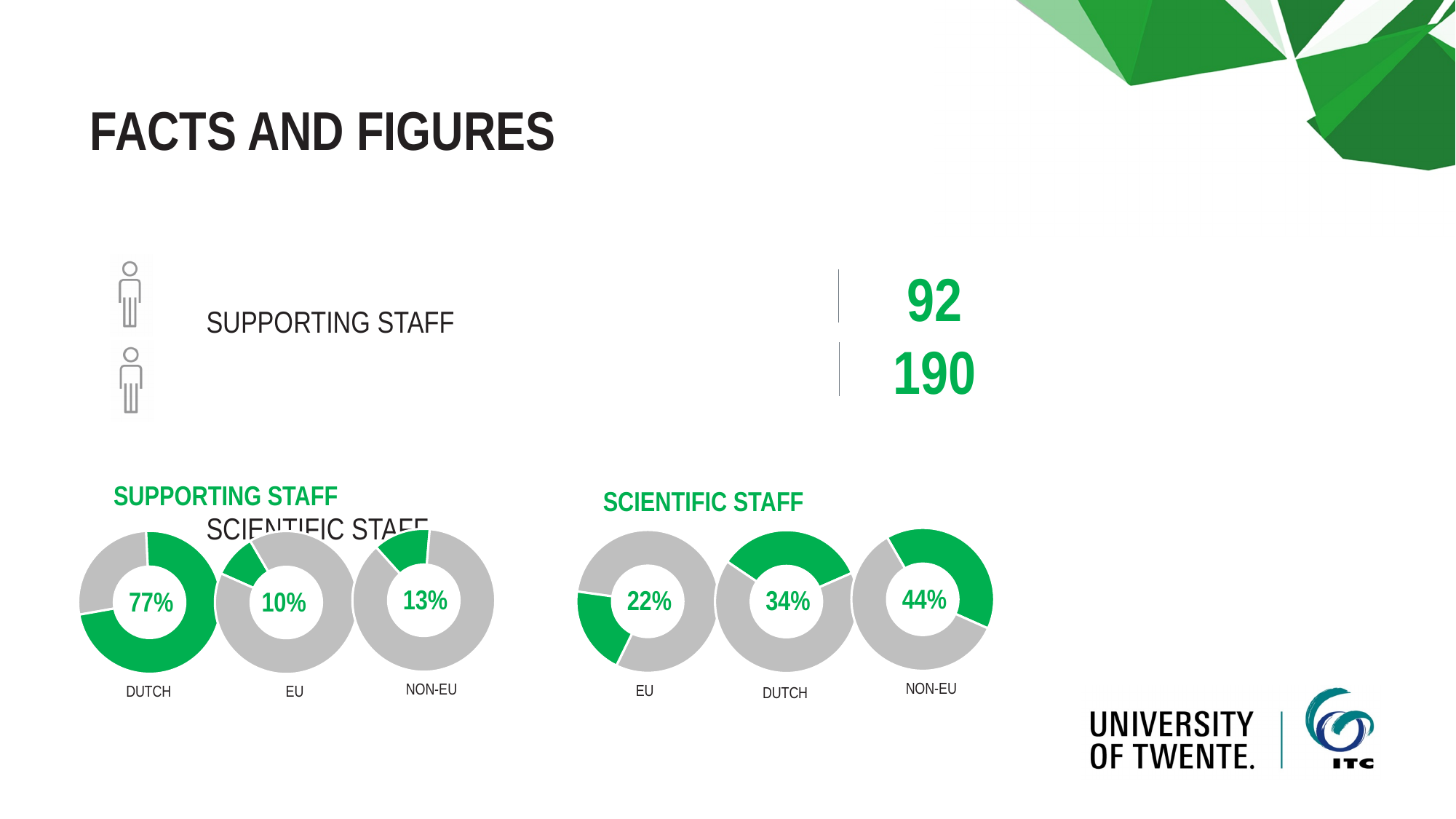
In the Scientific Staff donut charts, what percentage is shown for Non-EU? 44% What type of chart is used to show the staff percentages on the slide? Donut (pie) chart Which is larger: the Non-EU percentage for Scientific Staff or the Non-EU percentage for Supporting Staff? Scientific Staff How many donut charts are shown under the Scientific Staff heading? 3 In the Supporting Staff donut charts, what percentage is shown for Dutch? 77% Among the Scientific Staff donut charts, which category has the lowest percentage? EU In the Scientific Staff donut charts, what percentage is shown for EU? 22% Among the Supporting Staff donut charts, which category has the highest percentage? Dutch What is the difference between the Dutch percentage for Supporting Staff and the Dutch percentage for Scientific Staff? 43% In the Supporting Staff donut charts, what percentage is shown for Non-EU? 13% In the Scientific Staff donut charts, what percentage is shown for Dutch? 34% In the Supporting Staff donut charts, what percentage is shown for EU? 10%